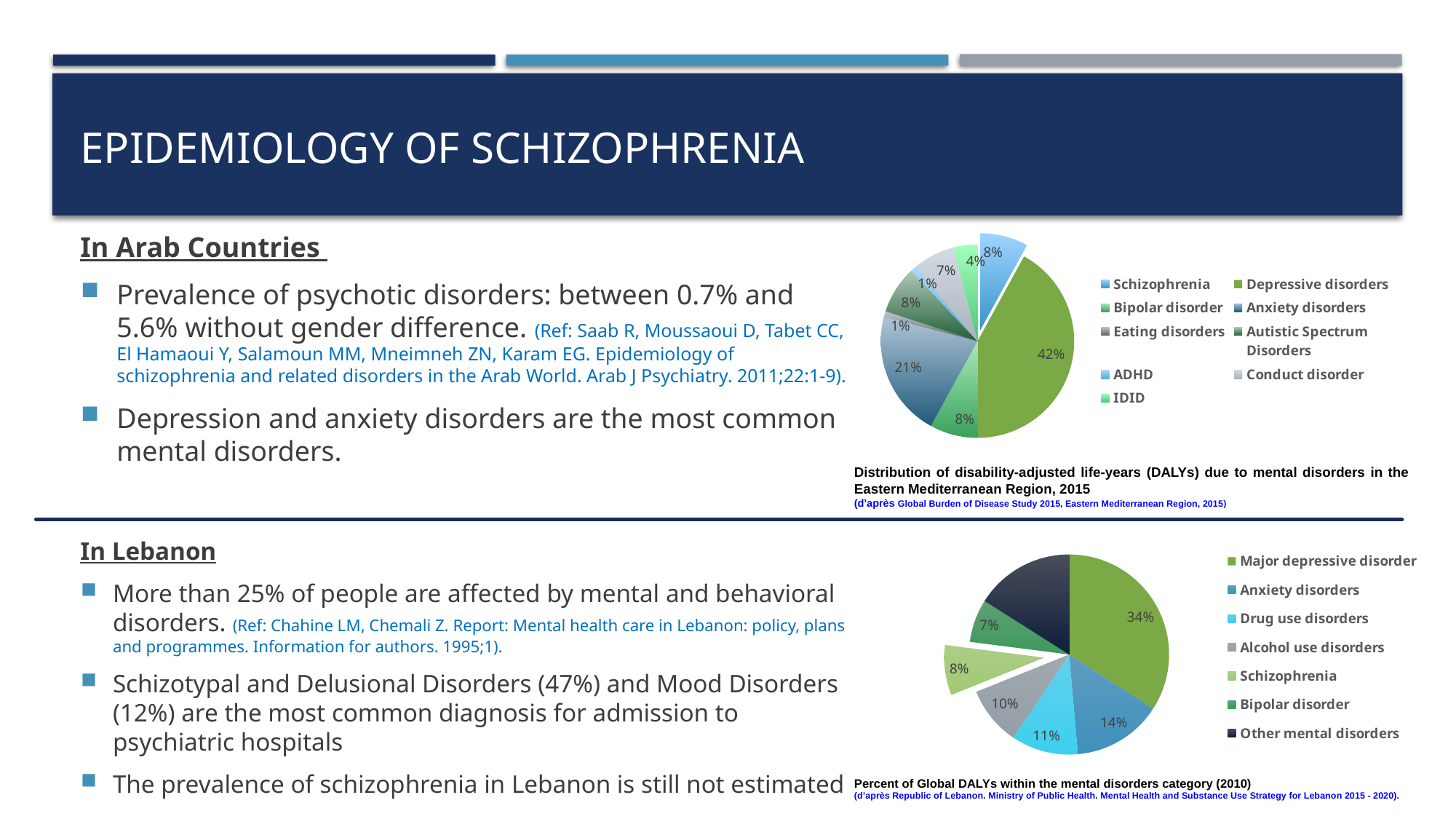
In the bottom pie chart (Percent of Global DALYs, 2010), what share is attributed to major depressive disorder? 34% What type of chart is used for the Eastern Mediterranean Region DALYs data at the top right? Pie chart In the top pie chart (Eastern Mediterranean Region, 2015), how many categories does the legend list? 9 In the bottom pie chart (Percent of Global DALYs, 2010), what share is attributed to bipolar disorder? 7% In the bottom pie chart (Percent of Global DALYs, 2010), which is larger: the share for anxiety disorders or the share for drug use disorders? Anxiety disorders In the top pie chart (Eastern Mediterranean Region, 2015), what is the difference between the shares for depressive disorders and anxiety disorders? 21% In the bottom pie chart (Percent of Global DALYs, 2010), how many categories does the legend list? 7 In the top pie chart (Eastern Mediterranean Region, 2015), what share of DALYs is attributed to depressive disorders? 42% In the top pie chart (Eastern Mediterranean Region, 2015), which category has the largest share? Depressive disorders In the top pie chart (Eastern Mediterranean Region, 2015), what share is attributed to anxiety disorders? 21% In the bottom pie chart (Percent of Global DALYs, 2010), what is the difference between the shares for major depressive disorder and anxiety disorders? 20% In the bottom pie chart (Percent of Global DALYs, 2010), what share is attributed to schizophrenia? 8%